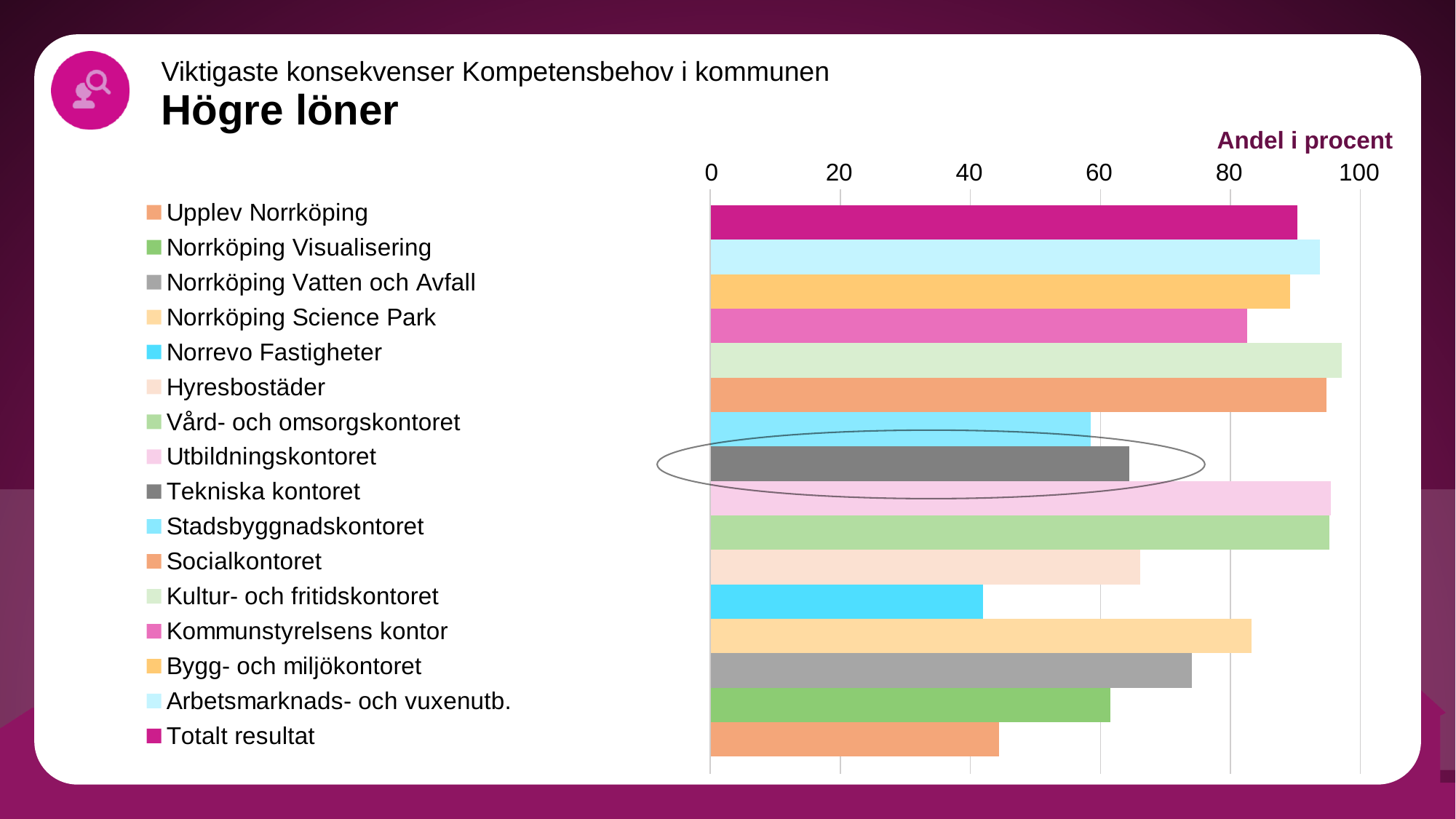
Is the value for Hyresbostäder greater or less than 60? greater Which has the larger value, Totalt resultat or Norrevo Fastigheter? Totalt resultat Is the value for Totalt resultat greater or less than 80? greater Which has the larger value, Kultur- och fritidskontoret or Stadsbyggnadskontoret? Kultur- och fritidskontoret Is the value for Norrköping Vatten och Avfall greater or less than 80? less What label is shown above the horizontal axis of the chart? Andel i procent What kind of chart is shown on the slide? bar chart How many categories does the legend list? 16 Which category's bar is circled on the chart? Tekniska kontoret